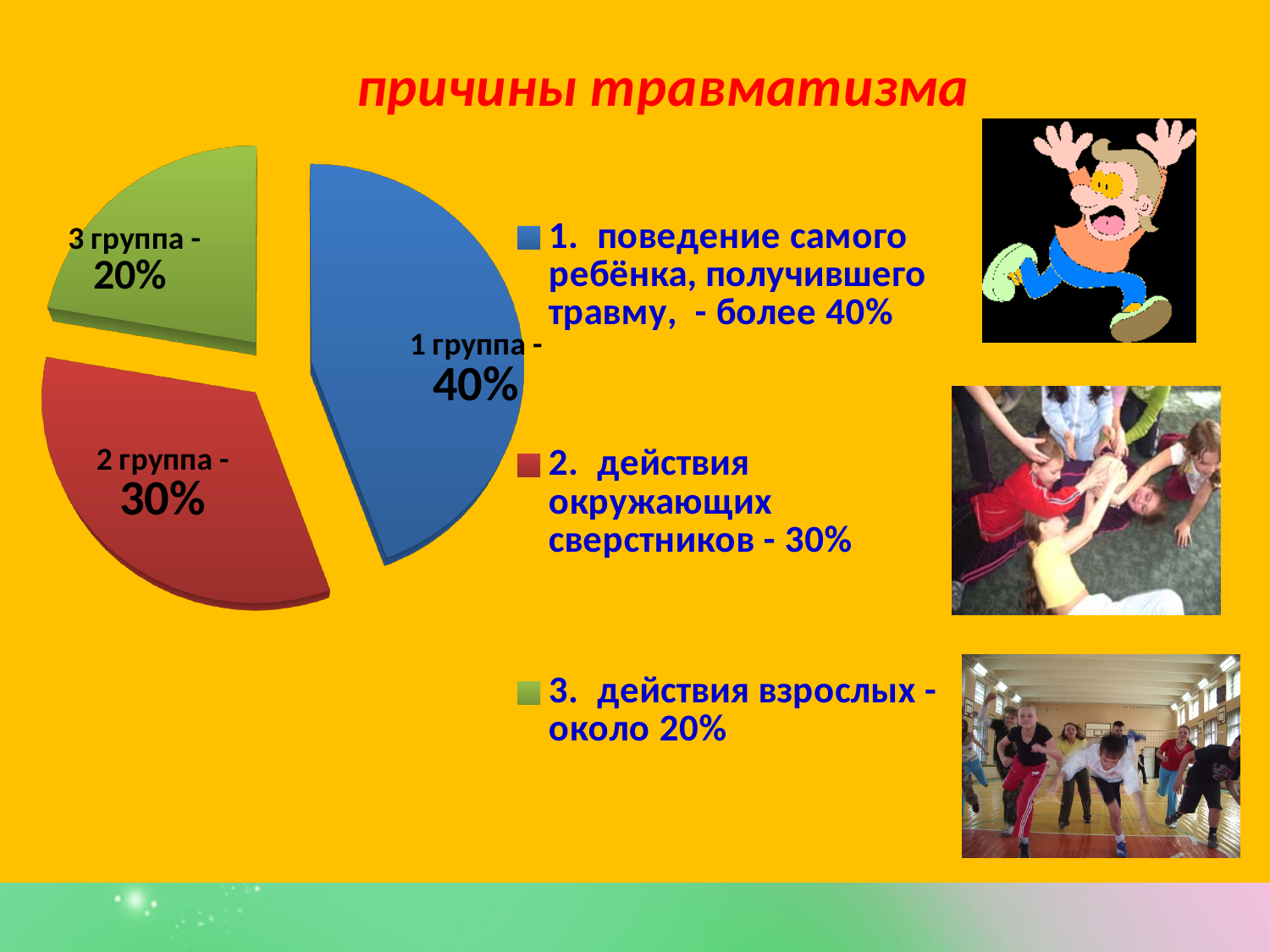
What is the difference between the values for 2 группа and 3 группа? 10% What kind of chart is shown on the slide? pie chart Which group has the largest slice in the pie chart? 1 группа What is the difference between the values for 1 группа and 3 группа? 20% What is the value shown for 3 группа in the pie chart? 20% How many slices does the pie chart have? 3 What colour is the slice for 2 группа? red Which is larger, the slice for 2 группа or the slice for 3 группа? 2 группа What is the value shown for 2 группа in the pie chart? 30% How many entries does the legend list? 3 Which group has the smallest slice in the pie chart? 3 группа What is the value shown for 1 группа in the pie chart? 40%